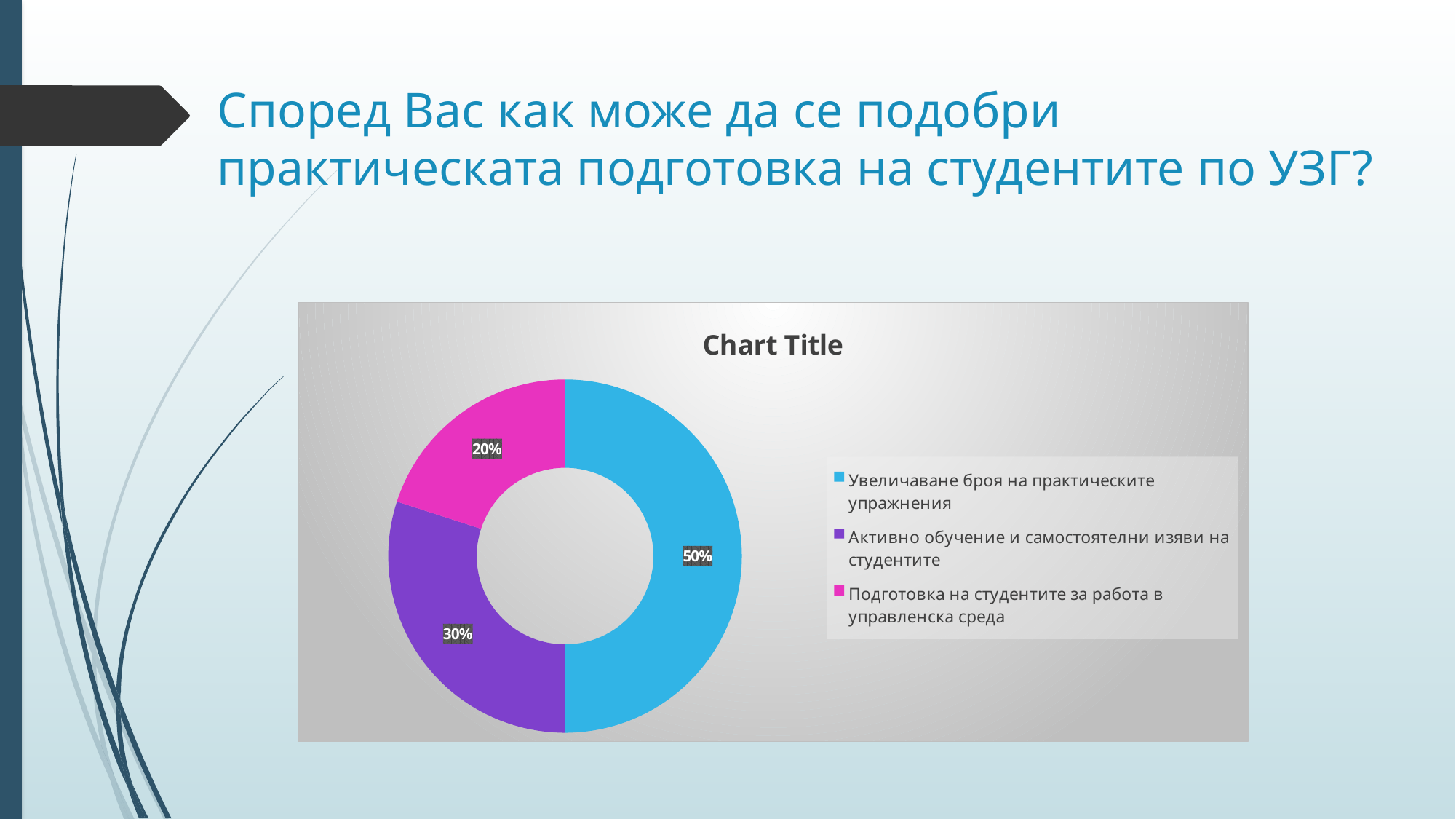
What is the value shown for "Активно обучение и самостоятелни изяви на студентите"? 30% How many categories does the chart show? 3 What is the difference between the values for "Увеличаване броя на практическите упражнения" and "Активно обучение и самостоятелни изяви на студентите"? 20% Which is larger: the slice for "Активно обучение и самостоятелни изяви на студентите" or the slice for "Подготовка на студентите за работа в управленска среда"? Активно обучение и самостоятелни изяви на студентите What colour is the slice for "Подготовка на студентите за работа в управленска среда"? Pink (magenta) Which category has the smallest slice? Подготовка на студентите за работа в управленска среда What is the difference between the values for "Активно обучение и самостоятелни изяви на студентите" and "Подготовка на студентите за работа в управленска среда"? 10% What kind of chart is shown on the slide? Doughnut (pie) chart What is the value shown for "Подготовка на студентите за работа в управленска среда"? 20% Which category has the largest slice? Увеличаване броя на практическите упражнения What share of the chart does the slice for "Увеличаване броя на практическите упражнения" represent? 50% What is the title of the chart? Chart Title